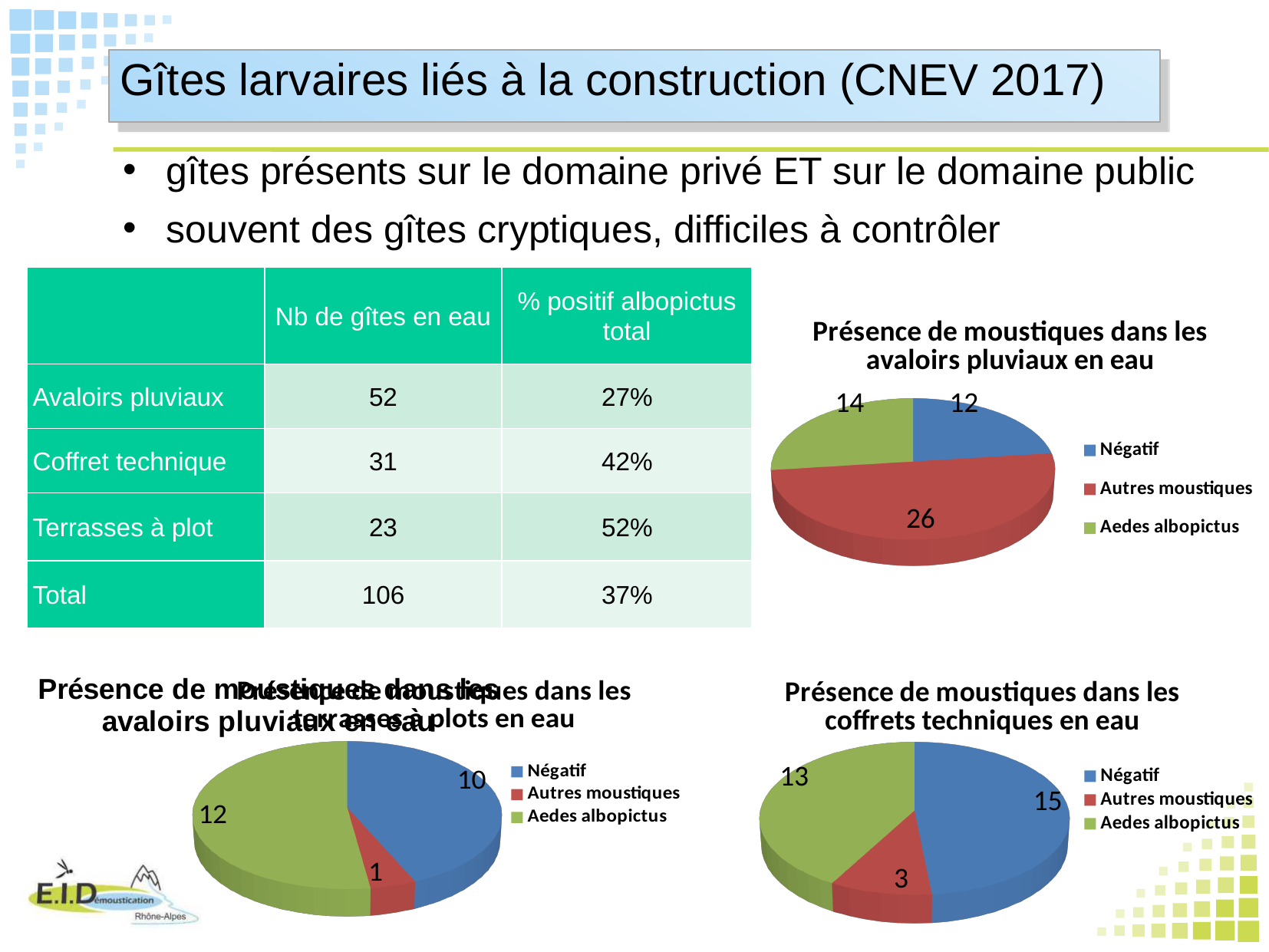
In the chart titled 'Présence de moustiques dans les coffrets techniques en eau' (bottom right), what is the value for Négatif? 15 In the chart titled 'Présence de moustiques dans les avaloirs pluviaux en eau' (top right), what is the difference between Autres moustiques and Aedes albopictus? 12 In the bottom-left pie chart, what is the value for Autres moustiques? 1 In the chart titled 'Présence de moustiques dans les avaloirs pluviaux en eau' (top right), which category has the largest slice? Autres moustiques How many entries does the legend list in the chart titled 'Présence de moustiques dans les coffrets techniques en eau' (bottom right)? 3 In the chart titled 'Présence de moustiques dans les avaloirs pluviaux en eau' (top right), what is the value for Autres moustiques? 26 In the bottom-left pie chart, which is larger, Négatif or Aedes albopictus? Aedes albopictus In the chart titled 'Présence de moustiques dans les coffrets techniques en eau' (bottom right), what is the total of all slices? 31 In the chart titled 'Présence de moustiques dans les avaloirs pluviaux en eau' (top right), what is the value for Négatif? 12 What kind of chart is the chart titled 'Présence de moustiques dans les avaloirs pluviaux en eau' (top right)? Pie chart In the bottom-left pie chart, what is the value for Aedes albopictus? 12 In the chart titled 'Présence de moustiques dans les coffrets techniques en eau' (bottom right), which category has the smallest slice? Autres moustiques